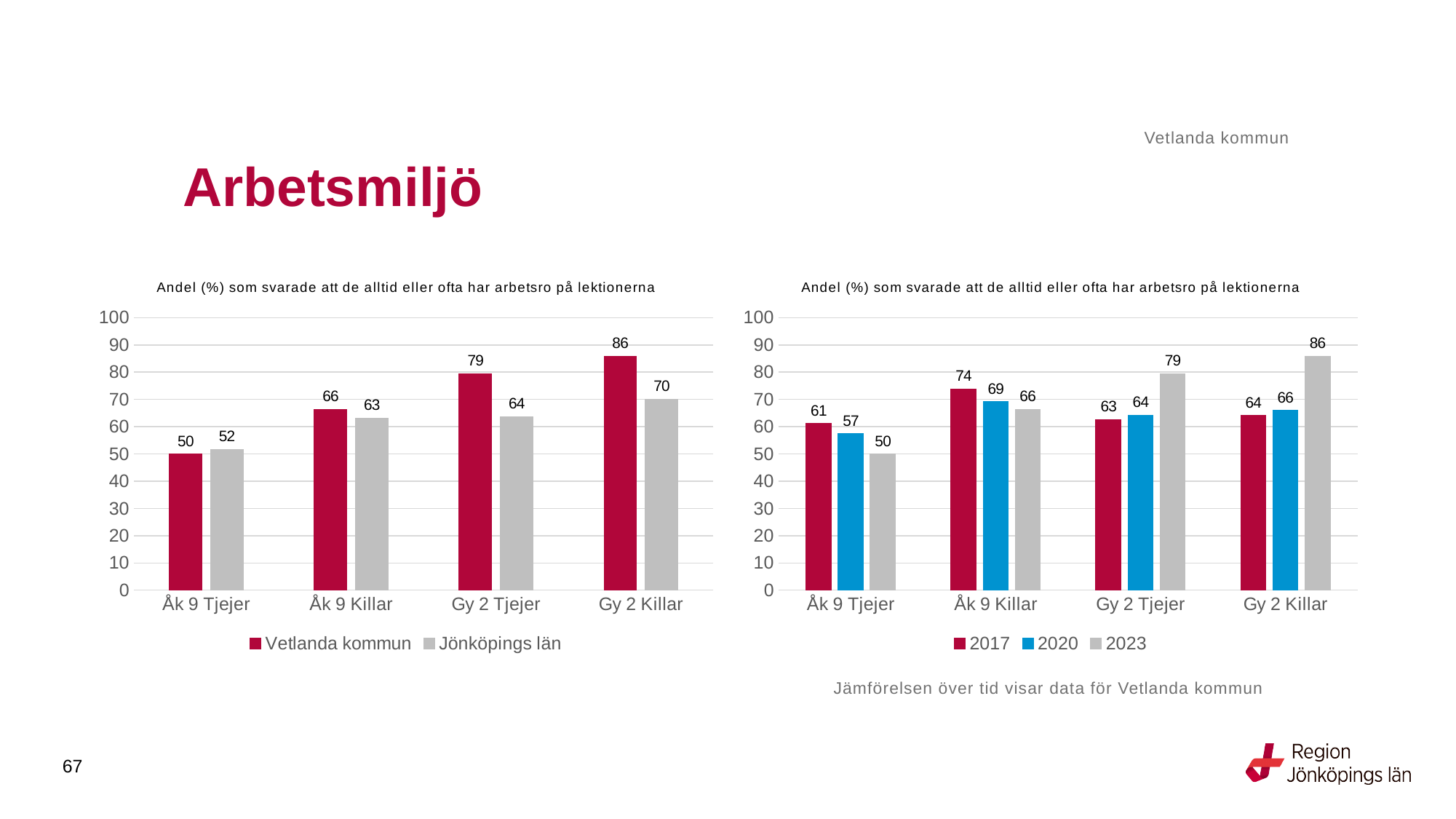
In the left chart, which category has the highest value for Vetlanda kommun? Gy 2 Killar In the right chart, what is the value for 2023 for Gy 2 Tjejer? 79 In the left chart, what is the value for Vetlanda kommun for Gy 2 Tjejer? 79 In the right chart, how many categories are shown on the x axis? 4 What kind of chart is the right chart? bar chart In the right chart, which is larger for Åk 9 Killar: 2017 or 2023? 2017 In the right chart, does the value for Åk 9 Tjejer rise or fall from 2017 to 2023? fall In the left chart, what is the difference between Vetlanda kommun and Jönköpings län for Gy 2 Killar? 16 In the left chart, what is the value for Jönköpings län for Åk 9 Killar? 63 In the left chart, which category has the lowest value for Jönköpings län? Åk 9 Tjejer In the right chart, what is the value for 2020 for Åk 9 Tjejer? 57 In the left chart, how many series does the legend list? 2